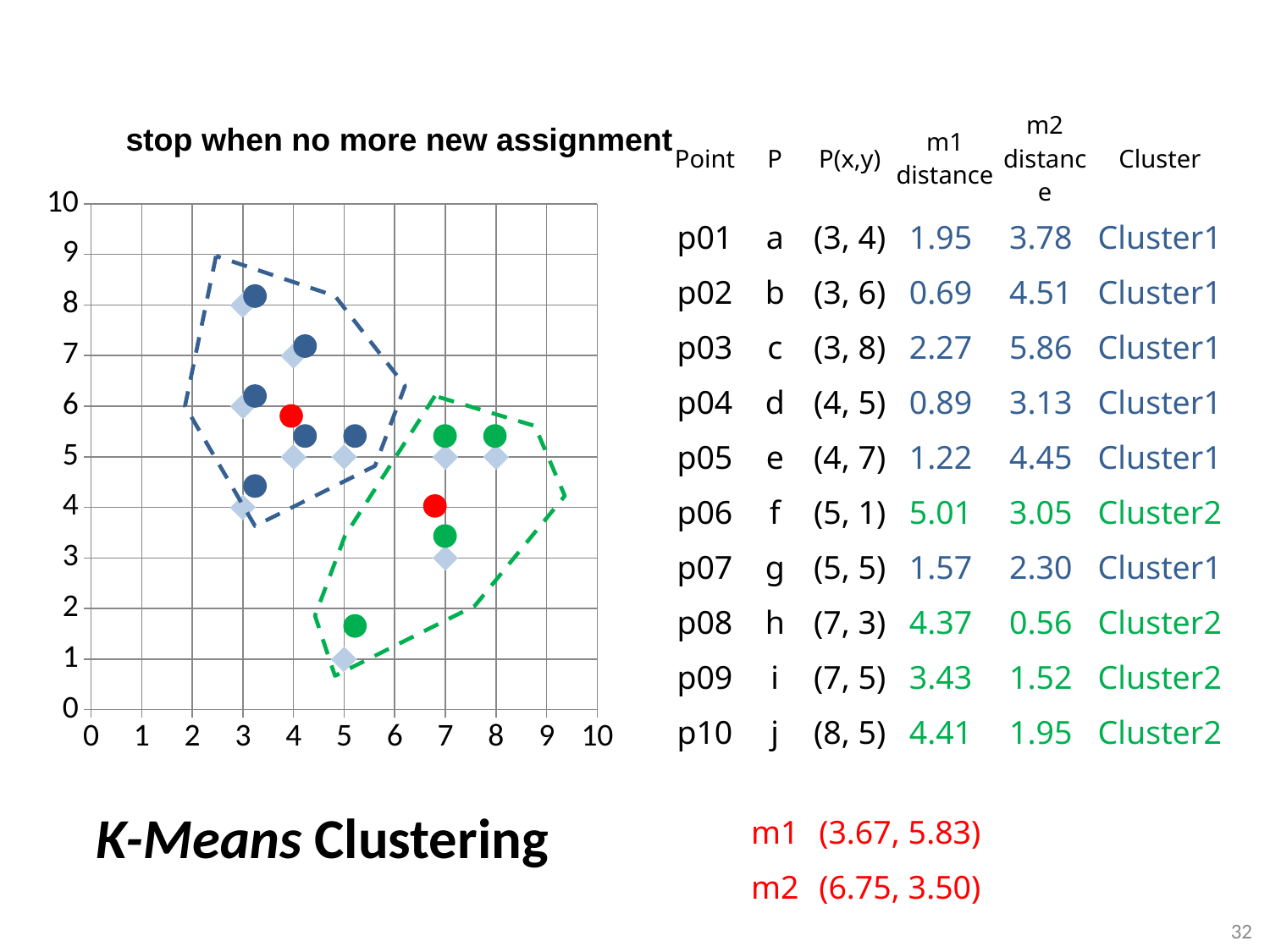
How many red circle points (centroids) are plotted on the chart? 2 How many light-blue diamond data points are plotted on the chart? 10 How many green circle points are plotted on the chart? 4 What is the highest value shown on the chart's y axis? 10 What kind of chart is shown on the slide? scatter chart Is the x value of the red centroid point inside the blue dashed outline greater or less than 5? less Is the y value of the red centroid point inside the green dashed outline greater or less than 5? less What is the y value of the highest light-blue diamond point on the chart? 8 What is the title of the chart? stop when no more new assignment What is the y value of the lowest light-blue diamond point on the chart? 1 What are the coordinates of centroid m1 as printed on the slide? (3.67, 5.83)